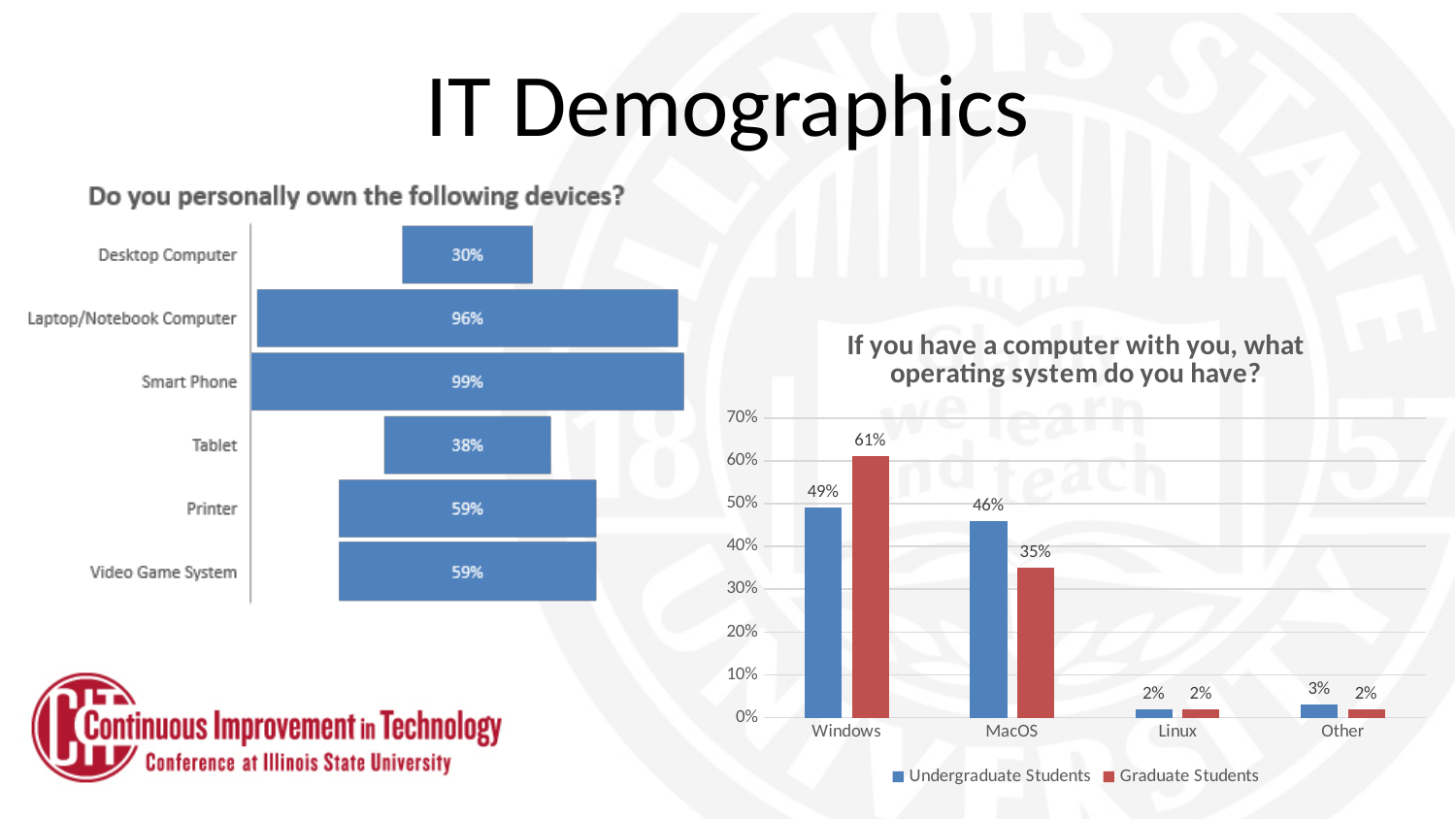
In the operating system chart, what is the difference between Graduate Students and Undergraduate Students for Windows? 12% In the operating system chart, what percentage of Graduate Students have Windows? 61% In the operating system chart, what percentage of Undergraduate Students have MacOS? 46% In the 'Do you personally own the following devices?' chart, which device has the highest ownership percentage? Smart Phone In the 'Do you personally own the following devices?' chart, what is the difference between the Laptop/Notebook Computer and Tablet percentages? 58% In the 'Do you personally own the following devices?' chart, how many devices are listed? 6 What type of chart is the 'Do you personally own the following devices?' chart? Bar chart In the operating system chart, which is larger for MacOS: Undergraduate Students or Graduate Students? Undergraduate Students In the 'Do you personally own the following devices?' chart, which device has the lowest ownership percentage? Desktop Computer How many series does the legend of the operating system chart list? 2 In the 'Do you personally own the following devices?' chart, what percentage own a Desktop Computer? 30% In the operating system chart, which operating system has the highest percentage for Undergraduate Students? Windows